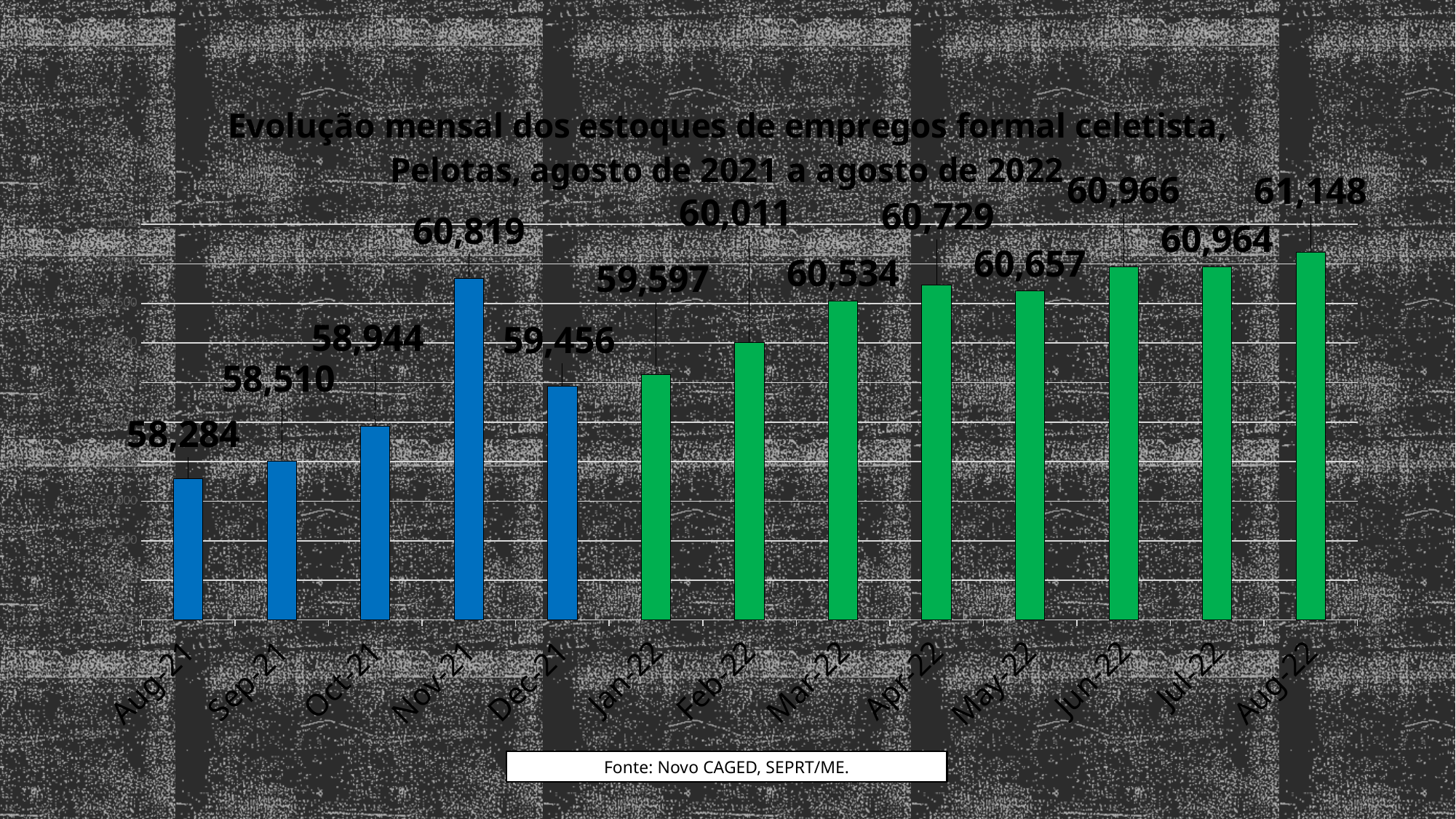
Which is larger, the value for Nov-21 or the value for Dec-21? Nov-21 How many months are shown on the x axis? 13 What is the difference between the values for Nov-21 and Dec-21? 1,363 What is the value for Nov-21? 60,819 What colour are the bars for the 2022 months? Green What is the value for Feb-22? 60,011 What kind of chart is shown on the slide? Bar chart What is the difference between the values for Aug-22 and Aug-21? 2,864 Which month has the highest value? Aug-22 Which is larger, the value for Mar-22 or the value for Jan-22? Mar-22 Which month has the lowest value? Aug-21 What is the value for Aug-22? 61,148